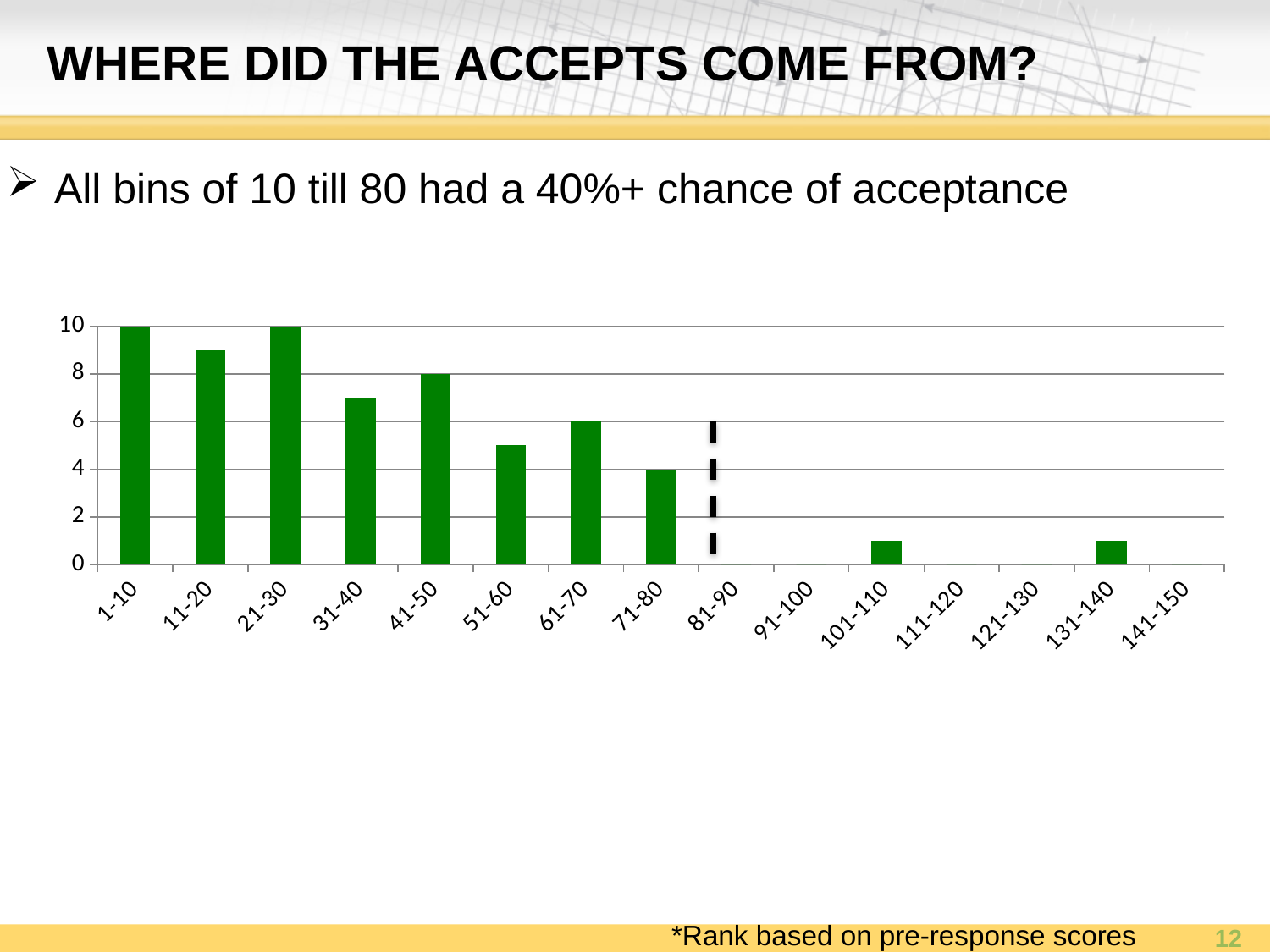
How many bins are shown on the x axis? 15 Is the value for the 101-110 bin greater or less than 2? less What is the difference between the values for the 1-10 bin and the 71-80 bin? 6 What is the value for the 41-50 bin? 8 What type of chart is shown on the slide? Bar chart Is the value for the 11-20 bin greater or less than 8? greater Do the values generally rise or fall from the 1-10 bin to the 141-150 bin? Fall Which bin has the larger value, 31-40 or 41-50? 41-50 What is the value for the 1-10 bin? 10 Is the value for the 31-40 bin greater or less than 8? less What is the value for the 71-80 bin? 4 What is the value for the 61-70 bin? 6